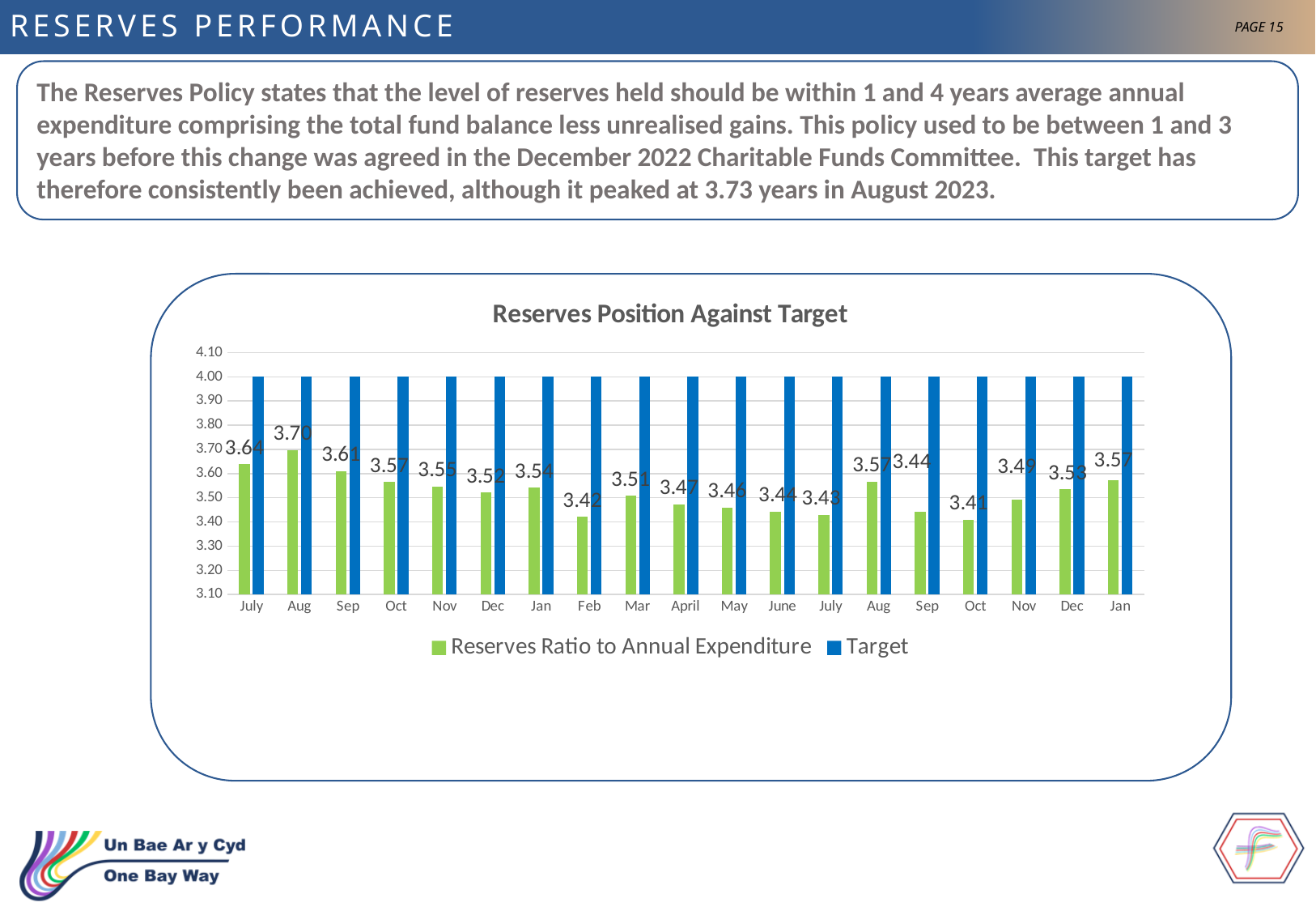
Which month has the lowest Reserves Ratio to Annual Expenditure? Oct (the second Oct) What is the difference between the highest Reserves Ratio (3.70) and the lowest (3.41)? 0.29 What value do the Target bars reach on the y axis? 4.00 What kind of chart is shown on the slide? Bar chart How many month categories are shown along the x axis of the chart? 19 What is the title of the chart? Reserves Position Against Target What is the Reserves Ratio to Annual Expenditure for the first Aug on the x axis? 3.70 Which has the larger Reserves Ratio to Annual Expenditure, Feb or Mar? Mar What is the Reserves Ratio to Annual Expenditure for Feb? 3.42 Which month has the highest Reserves Ratio to Annual Expenditure? Aug (the first Aug) How many series does the chart legend list? 2 Which colour represents the Target series in the chart? Blue